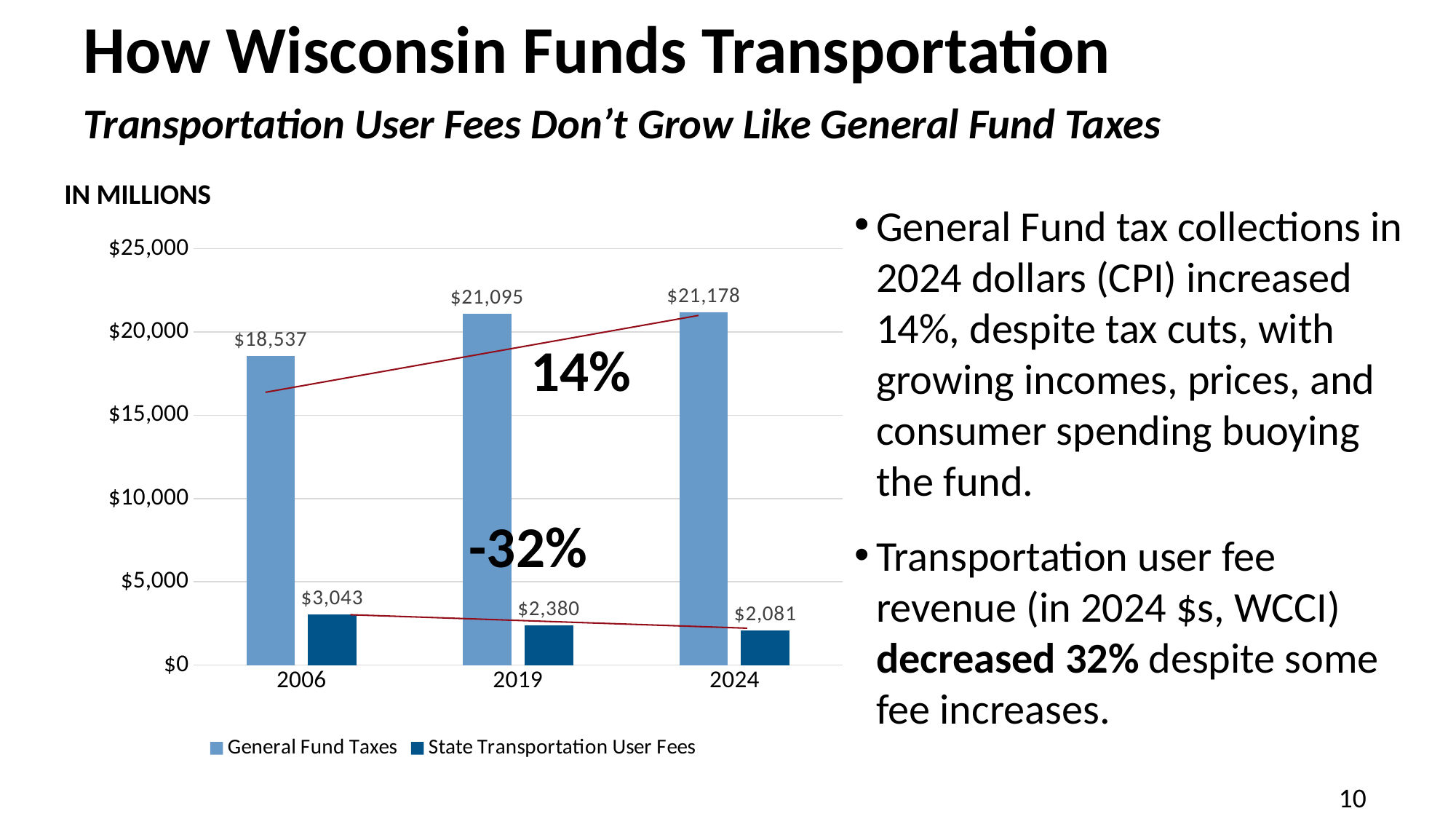
What kind of chart is shown on the slide? Bar chart How many series does the legend list? 2 What is the difference between General Fund Taxes in 2024 and in 2006? $2,641 How many years are shown on the x axis? 3 What is the value of State Transportation User Fees in 2019? $2,380 What is the value of State Transportation User Fees in 2024? $2,081 Is the value for General Fund Taxes in 2019 greater or less than $20,000? greater Which is larger: State Transportation User Fees in 2006 or in 2019? 2006 In which year are General Fund Taxes highest? 2024 In which year are State Transportation User Fees lowest? 2024 What is the value of General Fund Taxes in 2006? $18,537 What is the difference between State Transportation User Fees in 2006 and in 2024? $962